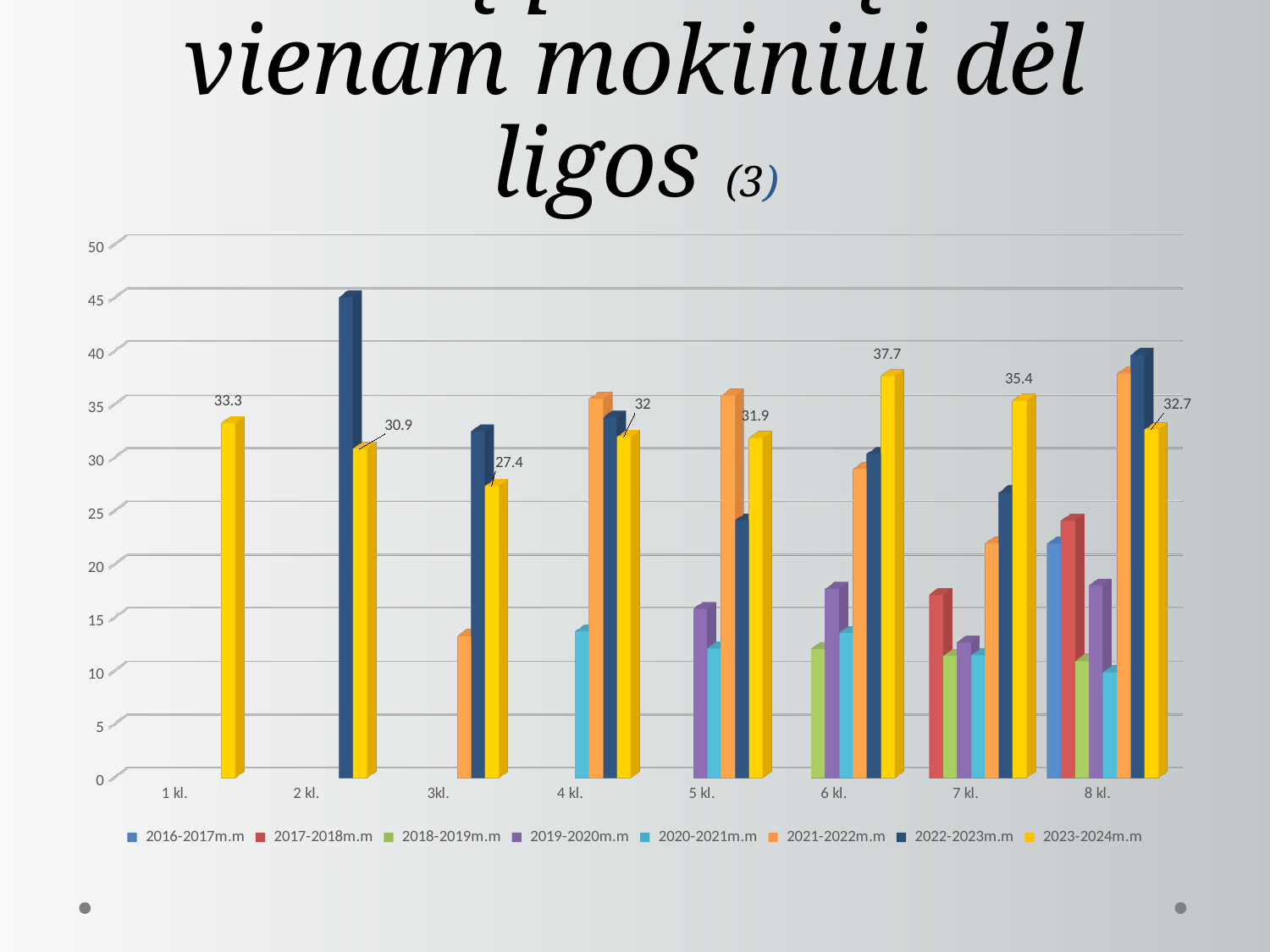
In the 2023-2024m.m series, which is larger: the value for 2 kl. or for 4 kl.? 4 kl. Which class has the highest value in the 2023-2024m.m series? 6 kl. What is the difference between the 2023-2024m.m values for 6 kl. and 3kl.? 10.3 What is the value for 6 kl. in the 2023-2024m.m series? 37.7 How many series does the legend list? 8 How many class categories are shown on the x axis? 8 Is the value for 4 kl. in the 2020-2021m.m series greater or less than 15? less What kind of chart is shown on the slide? bar chart What is the value for 1 kl. in the 2023-2024m.m series? 33.3 Which class has the lowest value in the 2023-2024m.m series? 3kl. Is the value for 2 kl. in the 2022-2023m.m series greater or less than 40? greater What is the value for 3kl. in the 2023-2024m.m series? 27.4